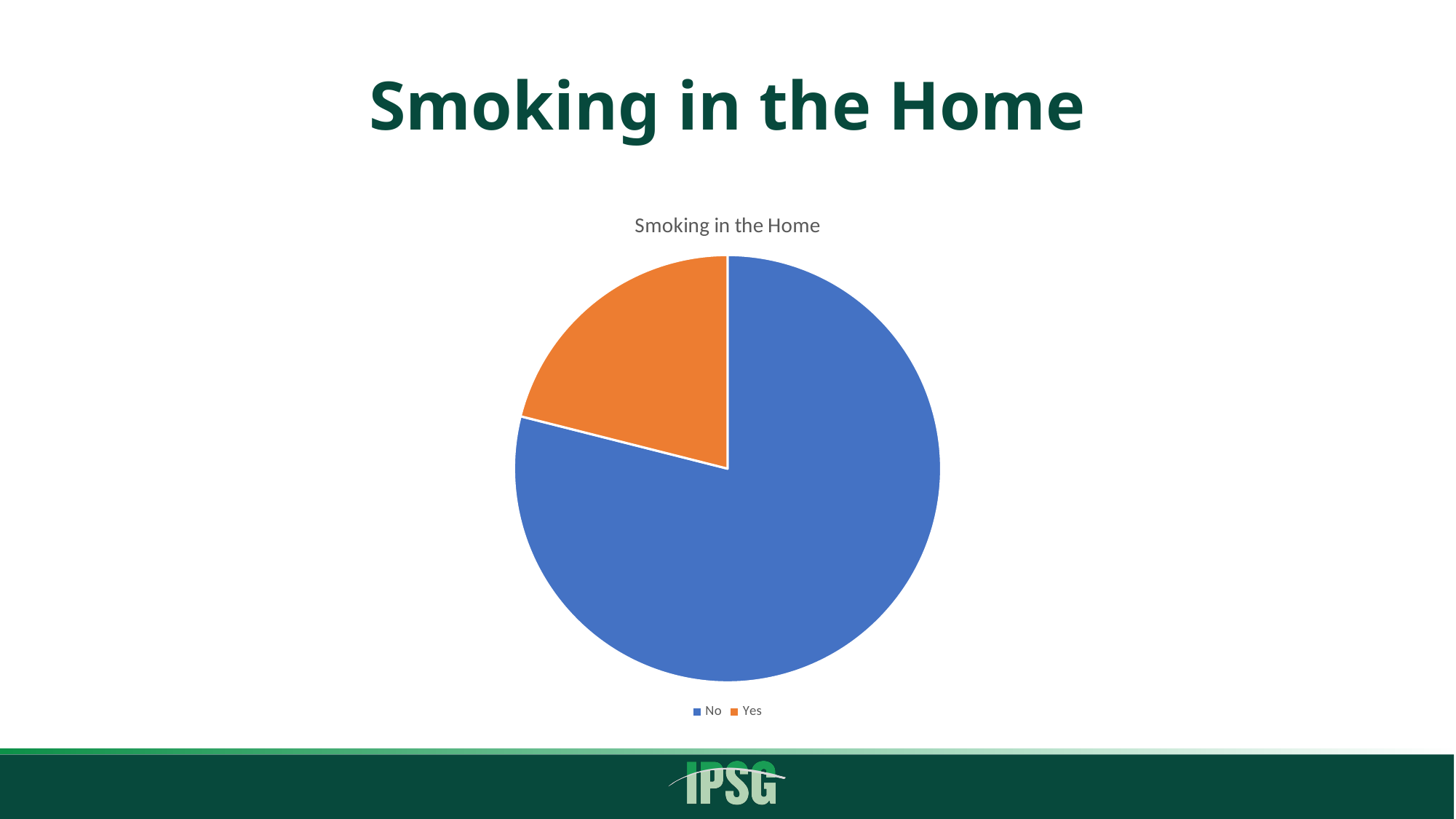
Does the 'No' slice take up more or less than half of the pie? more Which category has the largest slice of the pie? No Which category has the smallest slice of the pie? Yes How many entries does the legend list? 2 Which colour represents the 'Yes' category in the pie chart? orange Does the 'Yes' slice take up more or less than half of the pie? less What is the title of the chart? Smoking in the Home How many slices does the pie chart have? 2 What kind of chart is shown on the slide? pie chart Which slice is larger, No or Yes? No